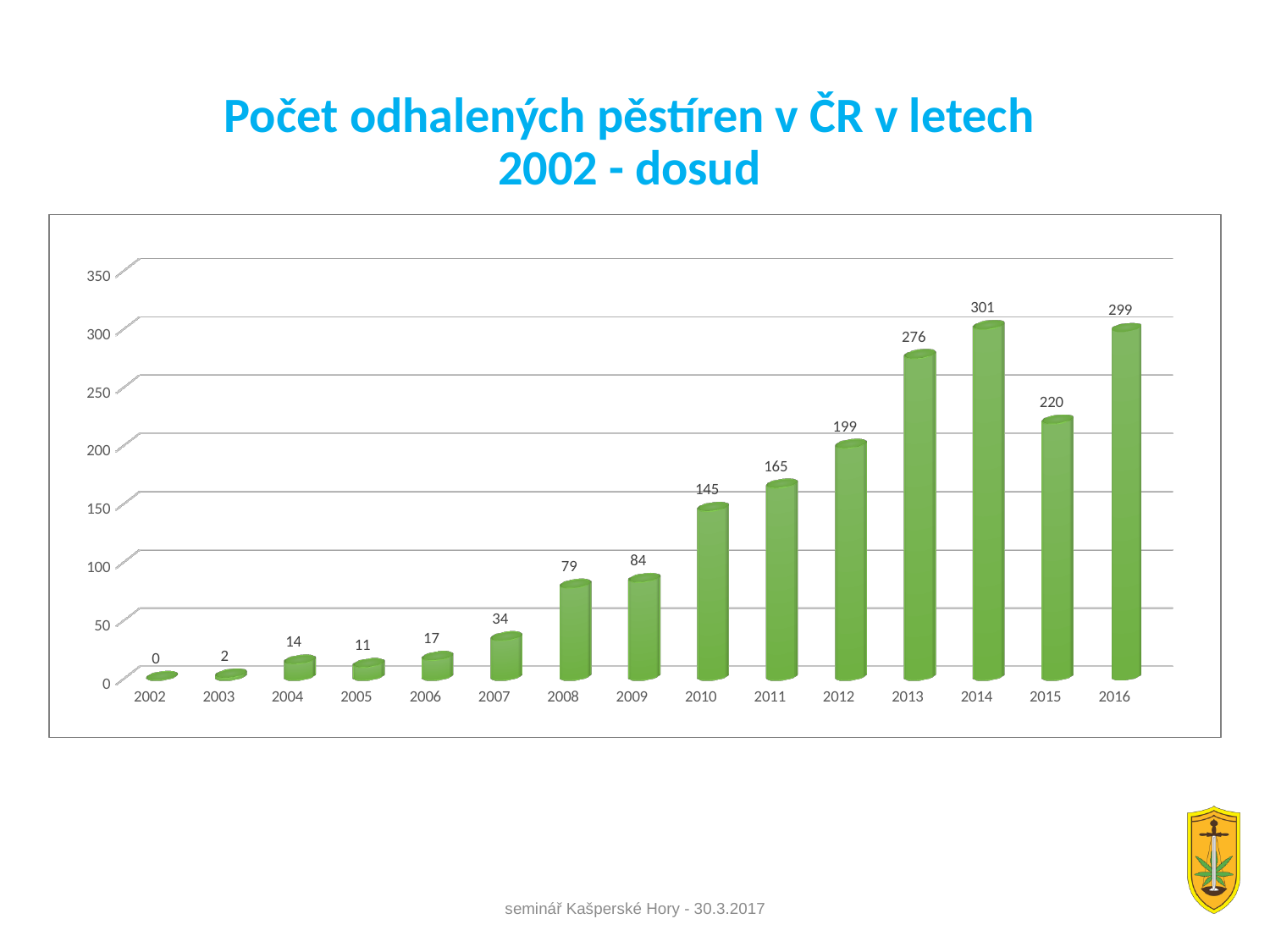
What is the value for 2005? 11 What kind of chart is shown on the slide? bar chart What is the value for 2010? 145 How many years are shown on the x axis? 15 Is the value for 2011 greater or less than 150? greater Do the values generally rise or fall from 2002 to 2014? rise What is the difference between the values for 2013 and 2012? 77 Which is larger, the value for 2008 or the value for 2009? 2009 What is the value for 2014? 301 Which year has the lowest value? 2002 What is the difference between the values for 2016 and 2015? 79 Which year has the highest value? 2014